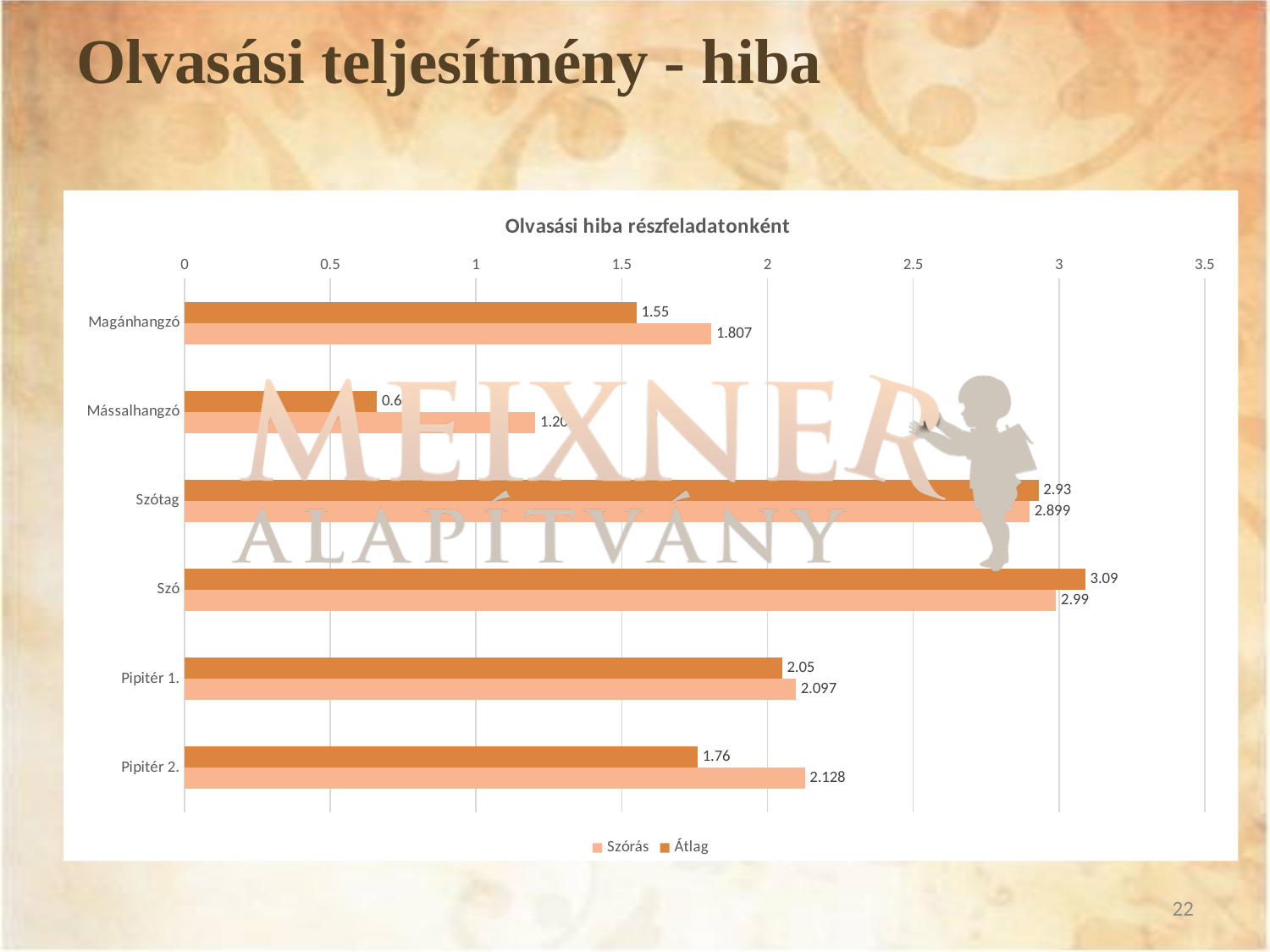
Which category has the lowest Átlag value? Mássalhangzó Which is larger for Pipitér 2., the Átlag value or the Szórás value? Szórás Is the Szórás value for Mássalhangzó greater or less than 1? greater What kind of chart is shown on the slide? Bar chart What is the title of the chart? Olvasási hiba részfeladatonként How many categories are shown on the chart? 6 What is the difference between the Átlag and Szórás values for Szó? 0.1 Which category has the highest Átlag value? Szó What is the Átlag value for Magánhangzó? 1.55 What is the Szórás value for Szótag? 2.899 What is the Szórás value for Pipitér 2.? 2.128 How many series does the legend list? 2